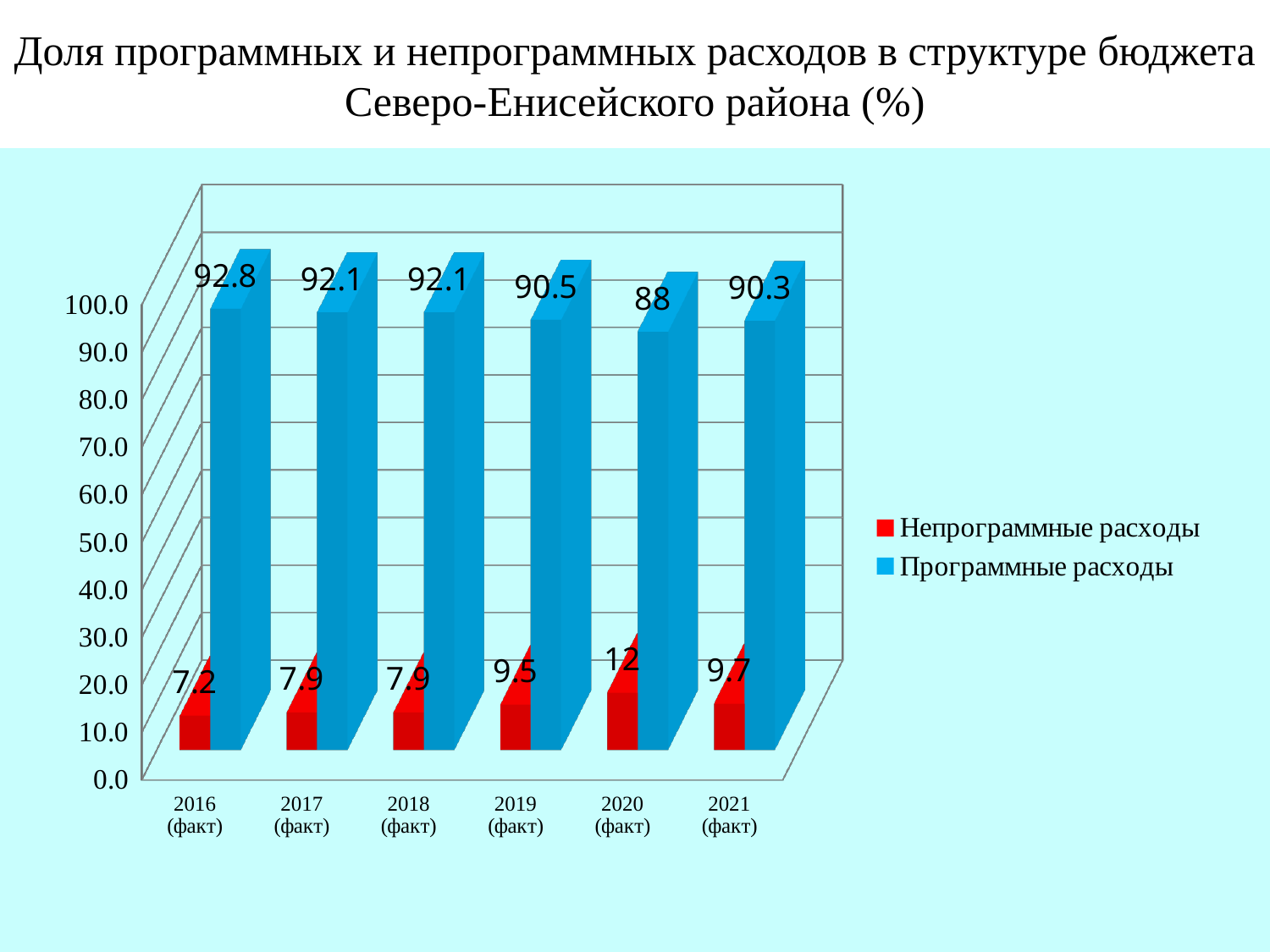
Which colour represents Непрограммные расходы in the legend? Red What is the value of Программные расходы for 2021 (факт)? 90.3 Which is larger: Непрограммные расходы in 2019 (факт) or in 2021 (факт)? 2021 (факт) In which year is Непрограммные расходы the lowest? 2016 (факт) How many series does the legend list? 2 In which year is Непрограммные расходы the highest? 2020 (факт) In which year is Программные расходы the lowest? 2020 (факт) What is the value of Программные расходы for 2016 (факт)? 92.8 What is the value of Непрограммные расходы for 2020 (факт)? 12 What is the difference between Программные расходы in 2016 (факт) and 2020 (факт)? 4.8 What kind of chart is shown on the slide? Bar chart How many years are shown on the x axis? 6